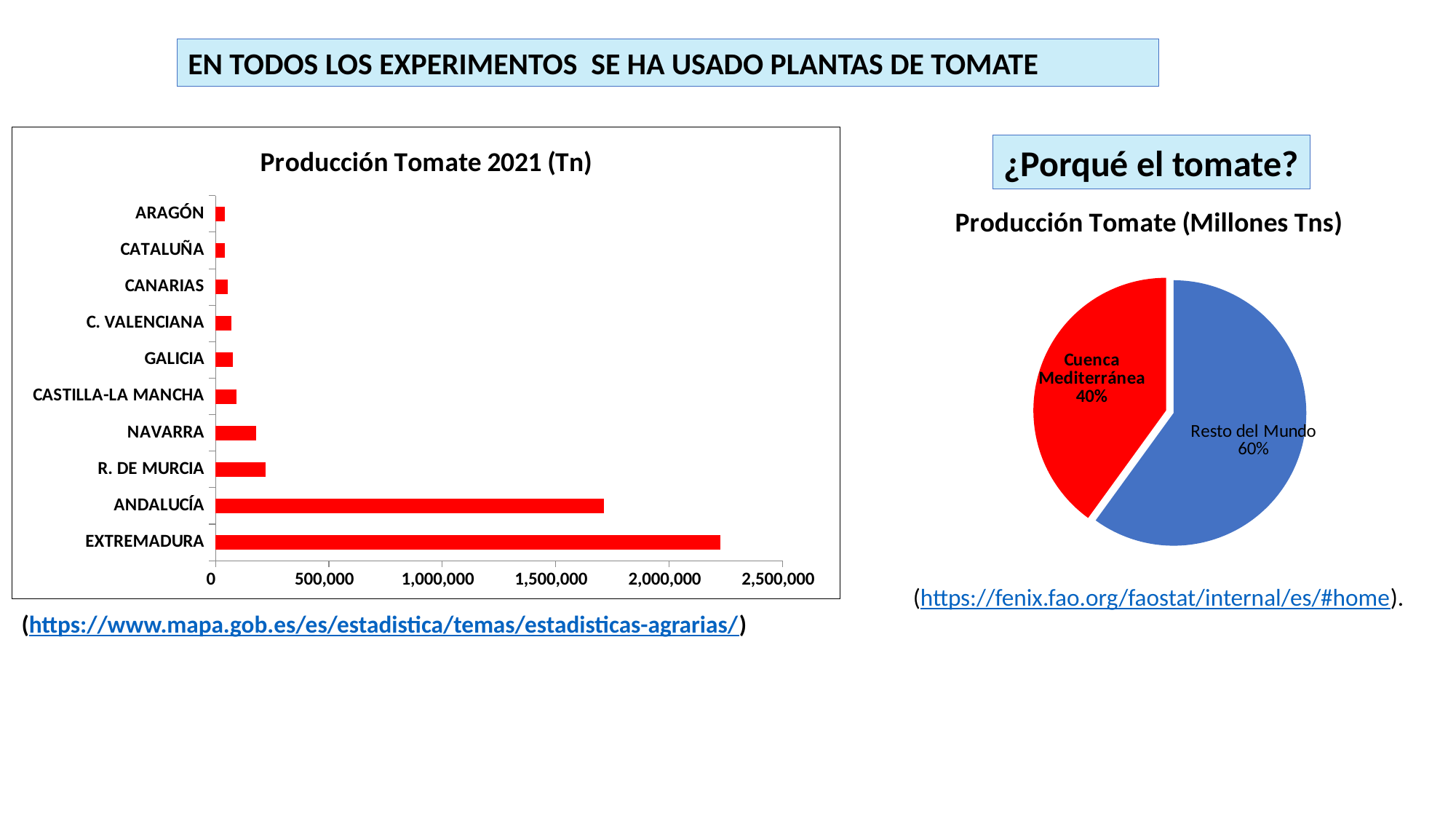
In the 'Producción Tomate 2021 (Tn)' chart, is the value for NAVARRA greater or less than 500,000? less In the 'Producción Tomate 2021 (Tn)' chart, which region has the highest production? EXTREMADURA In the 'Producción Tomate (Millones Tns)' pie chart, what share does Cuenca Mediterránea have? 40% In the 'Producción Tomate 2021 (Tn)' chart, is the value for EXTREMADURA greater or less than 2,000,000? greater In the 'Producción Tomate 2021 (Tn)' chart, which is larger, the value for NAVARRA or the value for ARAGÓN? NAVARRA In the 'Producción Tomate 2021 (Tn)' chart, which is larger, the value for ANDALUCÍA or the value for R. DE MURCIA? ANDALUCÍA In the 'Producción Tomate (Millones Tns)' pie chart, what colour is the Cuenca Mediterránea slice? red In the 'Producción Tomate (Millones Tns)' pie chart, what share does Resto del Mundo have? 60% In the 'Producción Tomate 2021 (Tn)' chart, how many regions are shown? 10 In the 'Producción Tomate 2021 (Tn)' chart, is the value for ANDALUCÍA greater or less than 1,500,000? greater In the 'Producción Tomate (Millones Tns)' pie chart, which slice is larger, Cuenca Mediterránea or Resto del Mundo? Resto del Mundo What kind of chart is 'Producción Tomate 2021 (Tn)'? bar chart